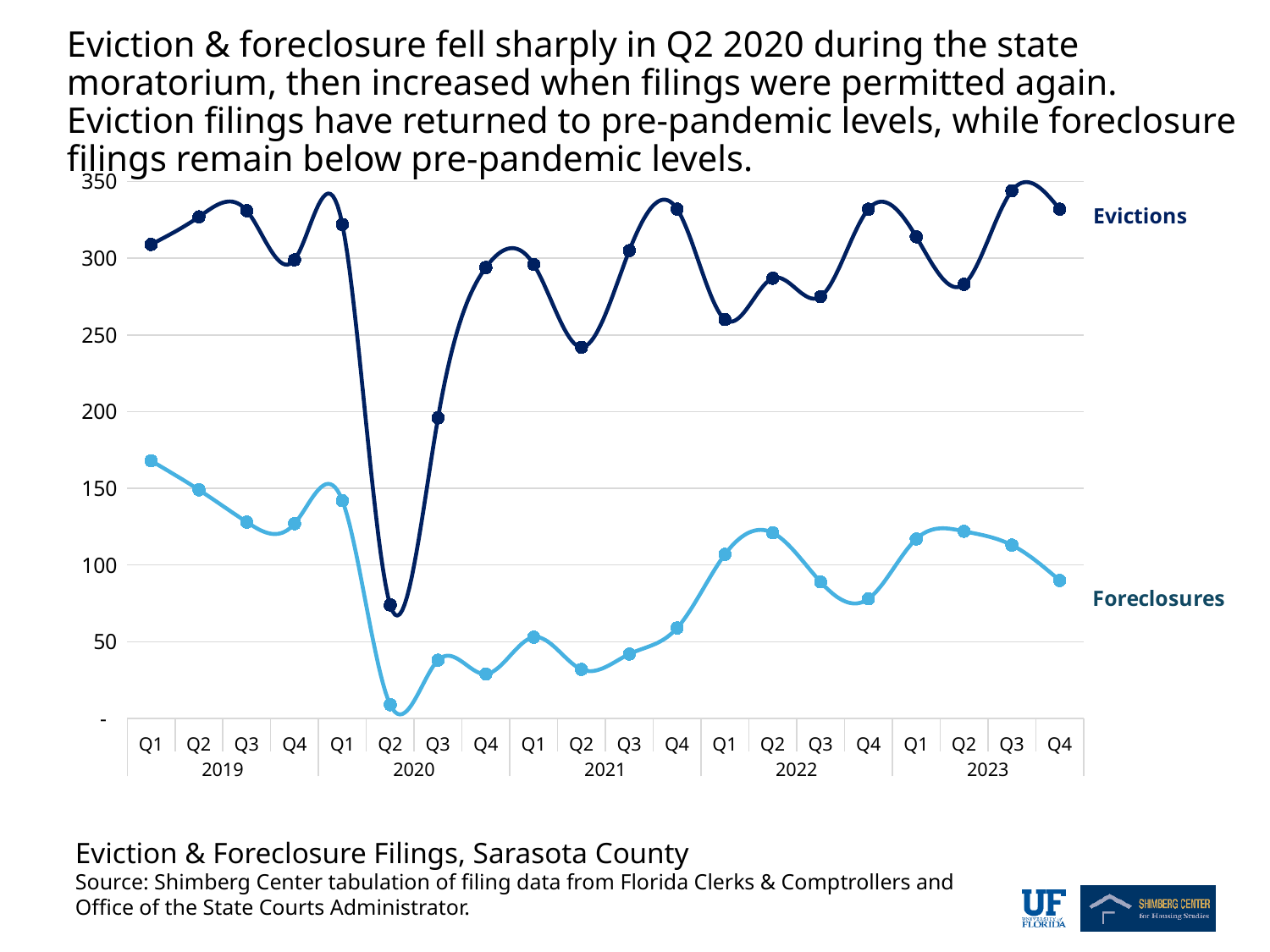
How many quarters are plotted along the x axis? 20 Is the value for Evictions in Q2 2020 greater or less than 100? less In which quarter do Evictions reach their lowest value? Q2 2020 Is the value for Foreclosures in Q1 2019 greater or less than 150? greater Which is larger: Foreclosures in Q1 2019 or Foreclosures in Q4 2023? Q1 2019 Is the value for Foreclosures in Q2 2022 greater or less than 100? greater In which quarter do Foreclosures reach their lowest value? Q2 2020 What kind of chart is shown on the slide? line chart Do Foreclosures rise or fall from Q1 2019 to Q4 2019? fall How many data series are plotted on the chart? 2 In which quarter do Foreclosures reach their highest value? Q1 2019